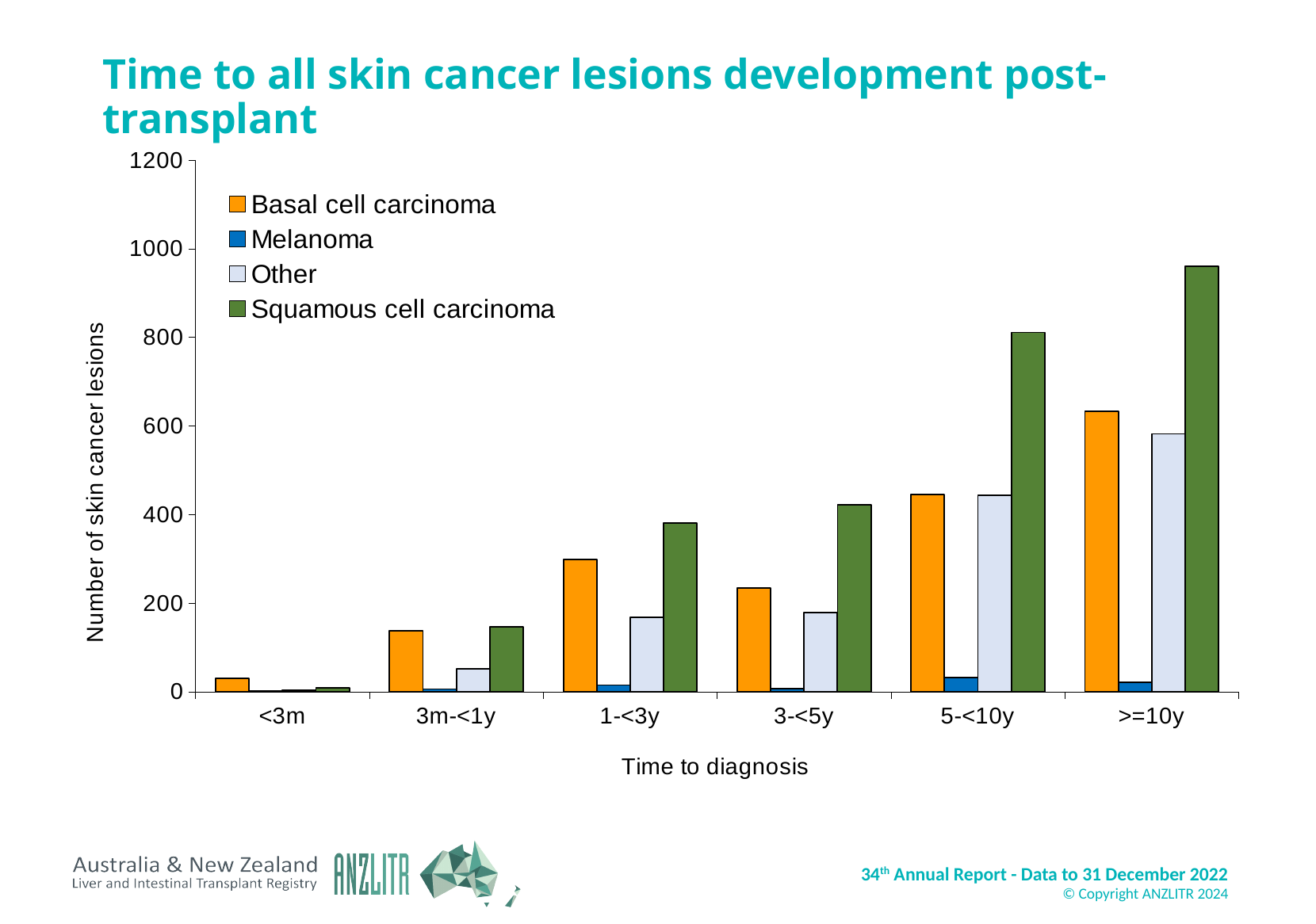
Is the value for Basal cell carcinoma at >=10y greater or less than 400? greater Is the value for Other at 1-<3y greater or less than 200? less Which series has the highest bar in the 5-<10y category? Squamous cell carcinoma What kind of chart is shown on the slide? bar chart In the 1-<3y category, which is larger: Basal cell carcinoma or Squamous cell carcinoma? Squamous cell carcinoma In the 3-<5y category, which is larger: Basal cell carcinoma or Other? Basal cell carcinoma Do the Squamous cell carcinoma values rise or fall as time to diagnosis increases along the x axis? rise Which time-to-diagnosis category has the highest Squamous cell carcinoma bar? >=10y How many series does the legend list? 4 How many time-to-diagnosis categories are shown on the x axis? 6 Which series has the lowest bar in the >=10y category? Melanoma Is the value for Squamous cell carcinoma at >=10y greater or less than 800? greater